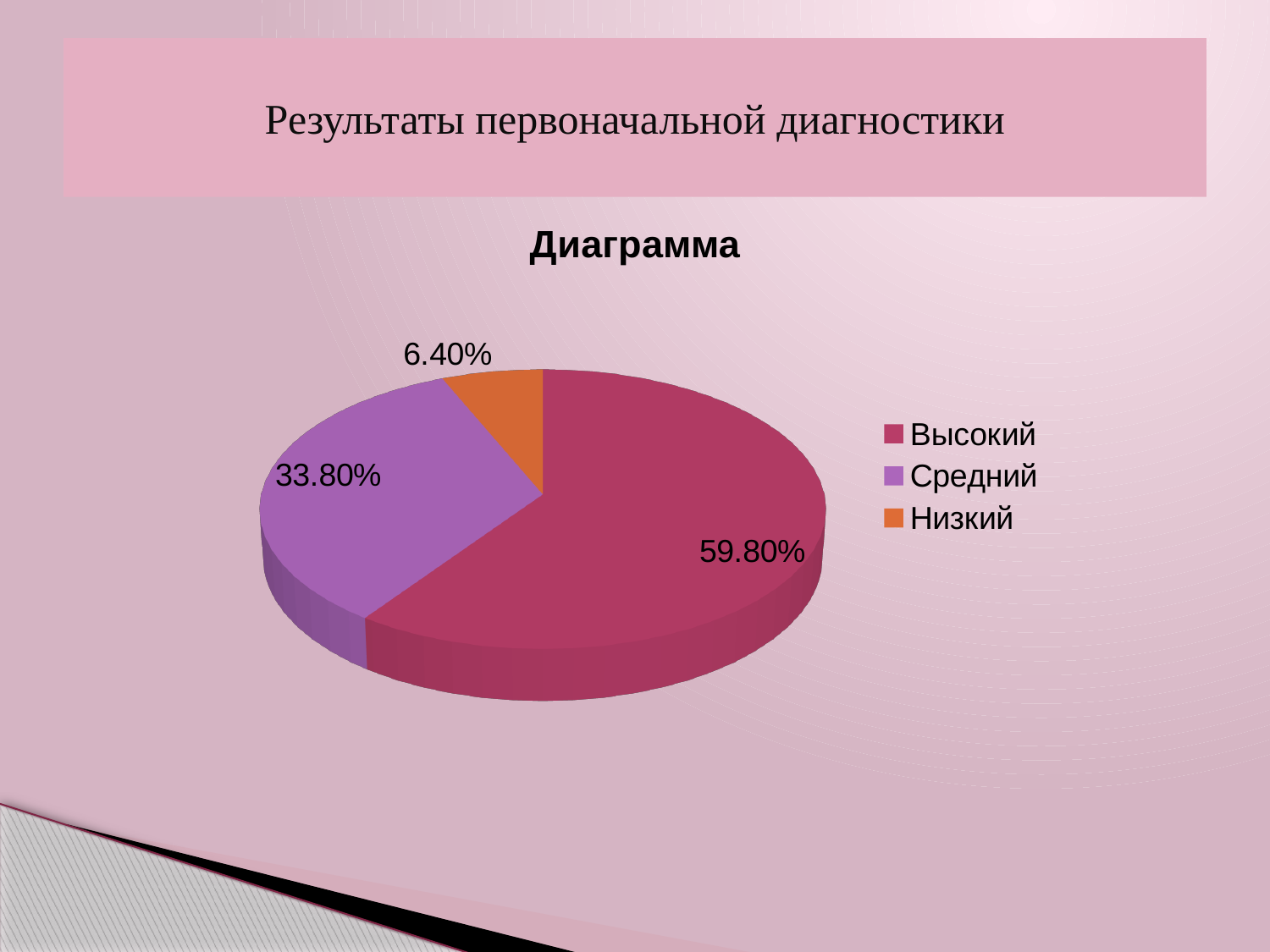
What is the title of the chart? Диаграмма Which category has the smallest share of the pie? Низкий What is the value for Высокий? 59.80% What is the value for Низкий? 6.40% Which colour represents Низкий in the legend? orange What is the value for Средний? 33.80% What is the difference between the values for Высокий and Средний? 26.00% Which is larger, the value for Средний or the value for Низкий? Средний How many categories does the pie chart have? 3 Which category has the largest share of the pie? Высокий What kind of chart is shown on the slide? pie chart What is the difference between the values for Средний and Низкий? 27.40%